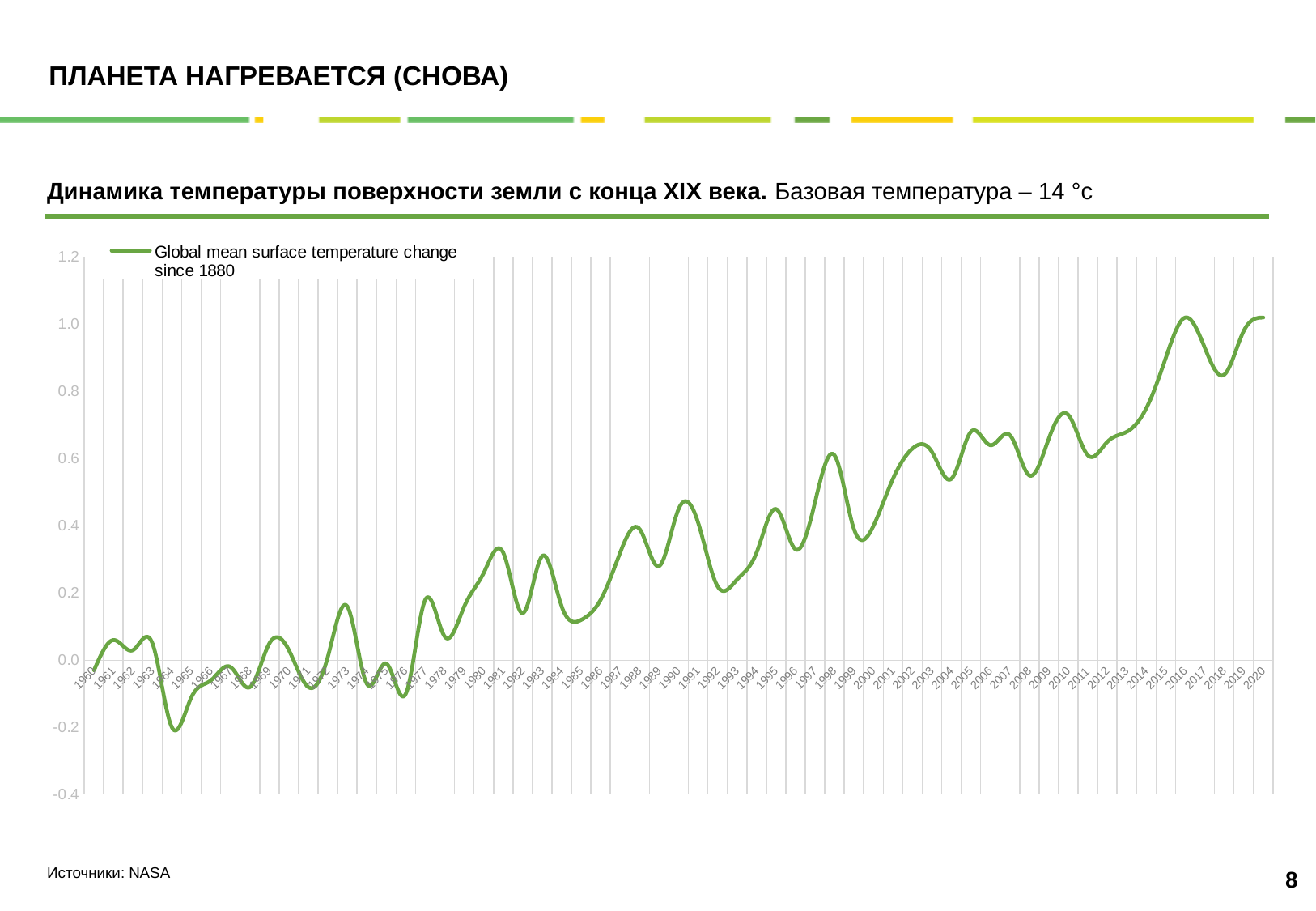
What kind of chart is shown on the slide? line chart What is the legend entry for the plotted series? Global mean surface temperature change since 1880 Is the value for 1964 greater or less than 0.0? less What is the first year shown on the x axis? 1960 Is the value for 1992 greater or less than 0.4? less Which year has the larger value, 2016 or 1964? 2016 Which year has the larger value, 1998 or 1999? 1998 Overall, do the values rise or fall from 1960 to 2020? rise Which year has the lowest value on the chart? 1964 Is the value for 2016 greater or less than 0.8? greater How many series does the legend list? 1